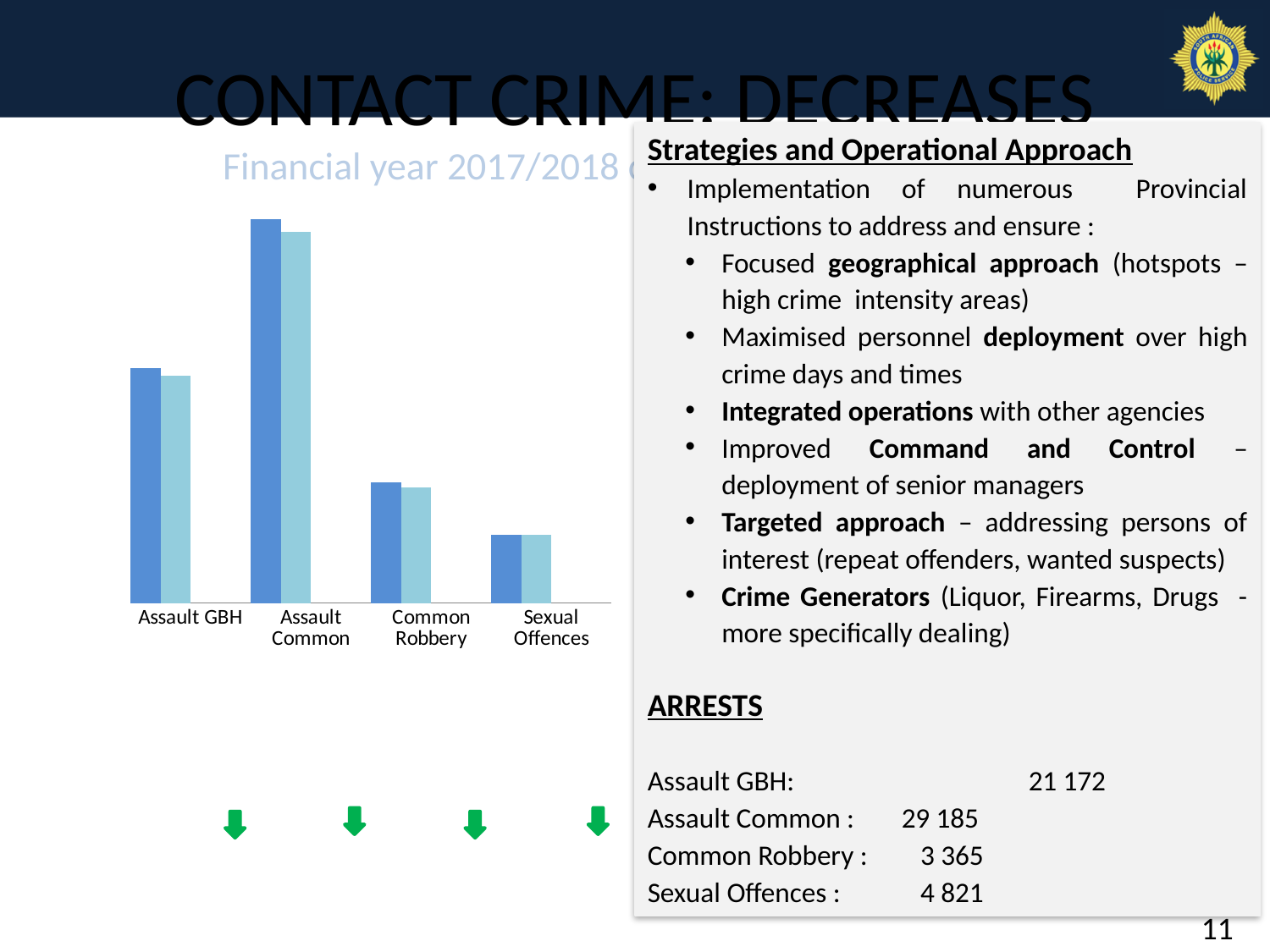
Which category has taller bars, Common Robbery or Sexual Offences? Common Robbery How many crime categories are shown on the x axis of the chart? 4 Which category has taller bars, Assault GBH or Common Robbery? Assault GBH How many bars are plotted for each crime category? 2 What kind of chart is shown on the slide? bar chart Which crime category has the tallest bars in the chart? Assault Common Which financial year is named in the chart title? 2017/2018 Which category has taller bars, Assault Common or Assault GBH? Assault Common Which crime category has the shortest bars in the chart? Sexual Offences